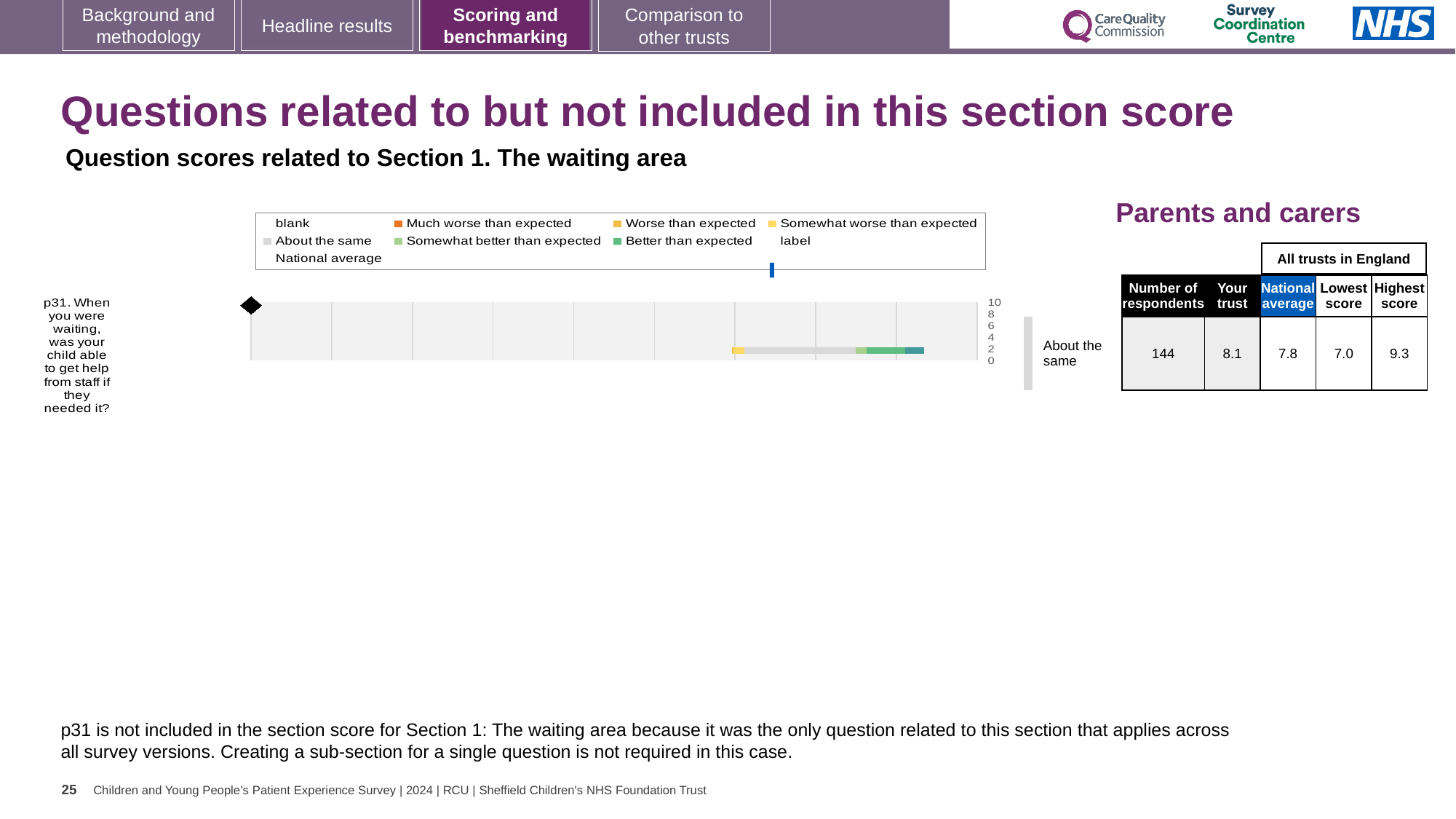
Is the 'Your trust' score for p31 greater or less than 8 on the chart's axis? greater How many questions are plotted in the chart? 1 What is the difference between the highest score and the lowest score for p31? 2.3 Which is larger for p31, the 'Your trust' score or the national average? Your trust What is the lowest score across all trusts in England for p31? 7.0 Which question is plotted in the chart? p31. When you were waiting, was your child able to get help from staff if they needed it? What is the national average score for p31 in the table? 7.8 What is the 'Your trust' score for p31 in the table? 8.1 How many respondents answered p31? 144 What benchmark category label is shown to the right of the p31 bar? About the same What kind of chart is used to show the p31 question score? bar chart What is the highest score across all trusts in England for p31? 9.3